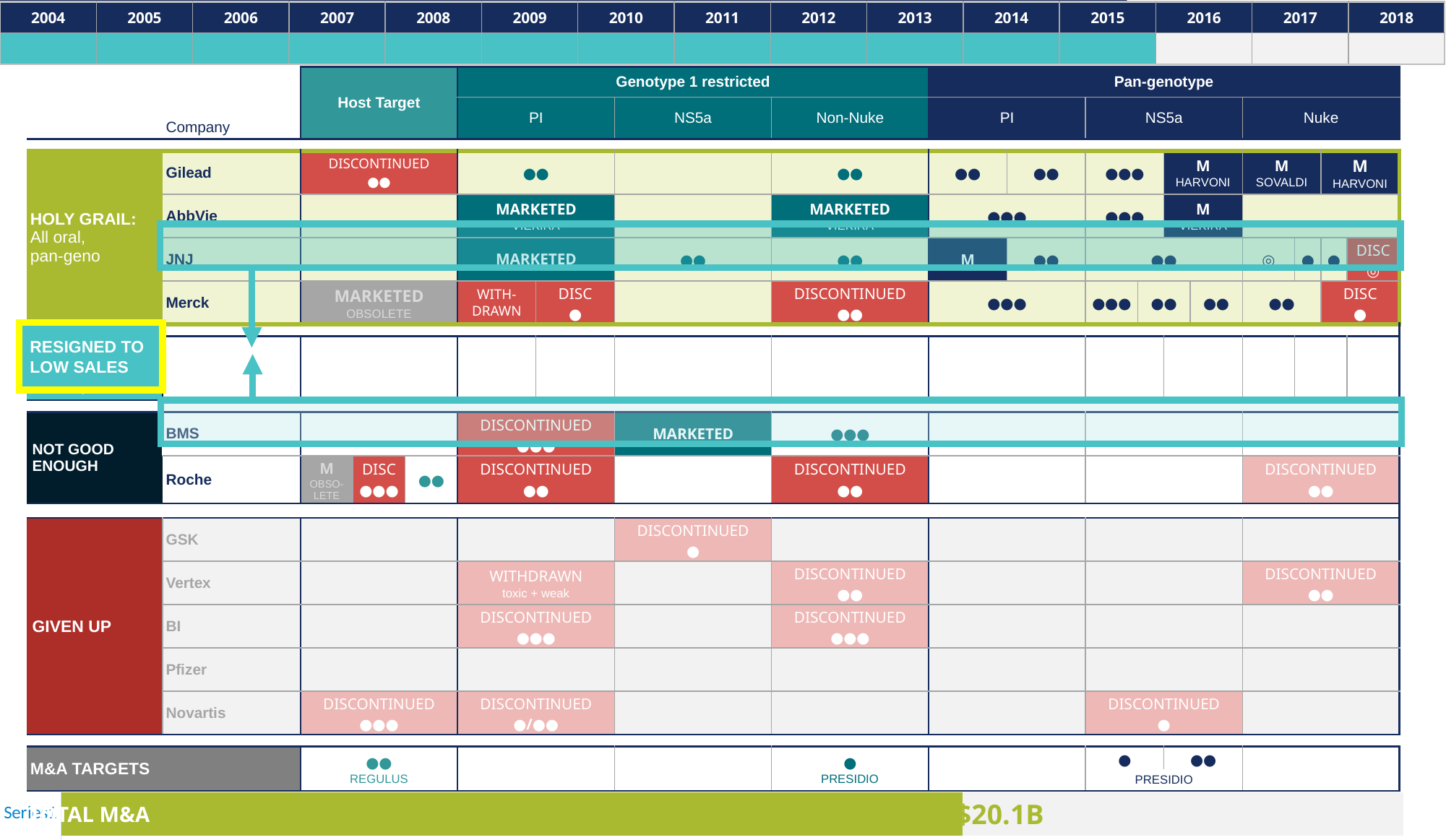
What is the first year shown on the timeline at the top of the slide? 2004 What kind of chart is the TOTAL M&A graphic at the bottom of the slide? bar chart Through which year does the teal shading on the top timeline extend? 2015 How many year columns does the timeline at the top of the slide show? 15 What series label appears at the left of the TOTAL M&A bar at the bottom of the slide? Series1 How many bars does the TOTAL M&A chart at the bottom of the slide show? 2 What is the last year shown on the timeline at the top of the slide? 2018 What value is printed on the TOTAL M&A bar at the bottom of the slide? $20.1B